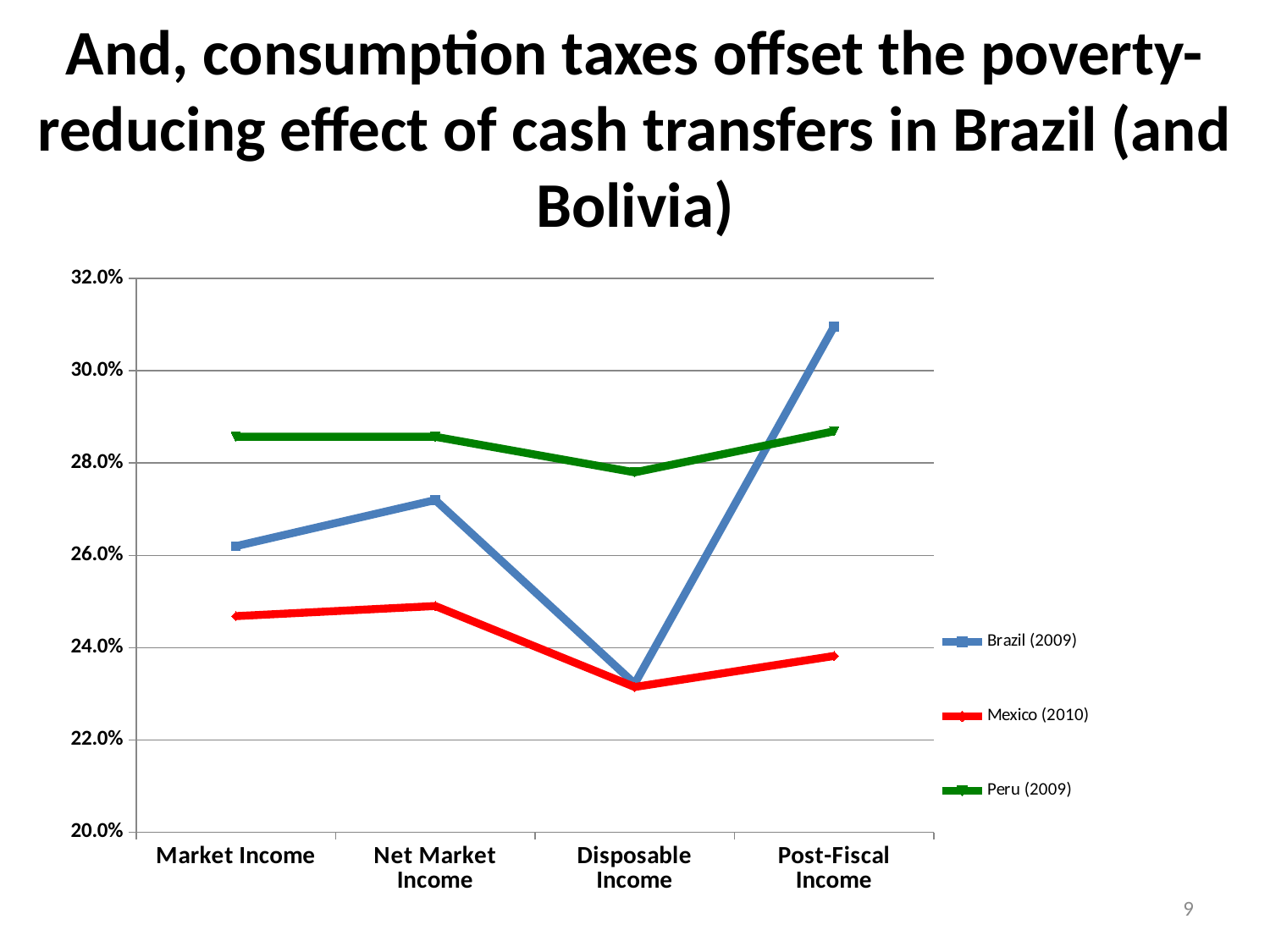
Which series has the lowest value at Market Income? Mexico (2010) How many income categories are shown on the x axis? 4 At which income category does the Brazil (2009) line reach its highest value? Post-Fiscal Income Is the value for Peru (2009) at Market Income greater or less than 28.0%? greater Is the value for Mexico (2010) at Disposable Income greater or less than 24.0%? less At which income category does the Brazil (2009) line reach its lowest value? Disposable Income Is the value for Brazil (2009) at Post-Fiscal Income greater or less than 30.0%? greater Which series has the highest value at Post-Fiscal Income? Brazil (2009) Does the Brazil (2009) line rise or fall from Net Market Income to Disposable Income? fall At Net Market Income, which is larger: the value for Peru (2009) or the value for Brazil (2009)? Peru (2009) What kind of chart is shown on the slide? line chart How many series does the legend list? 3